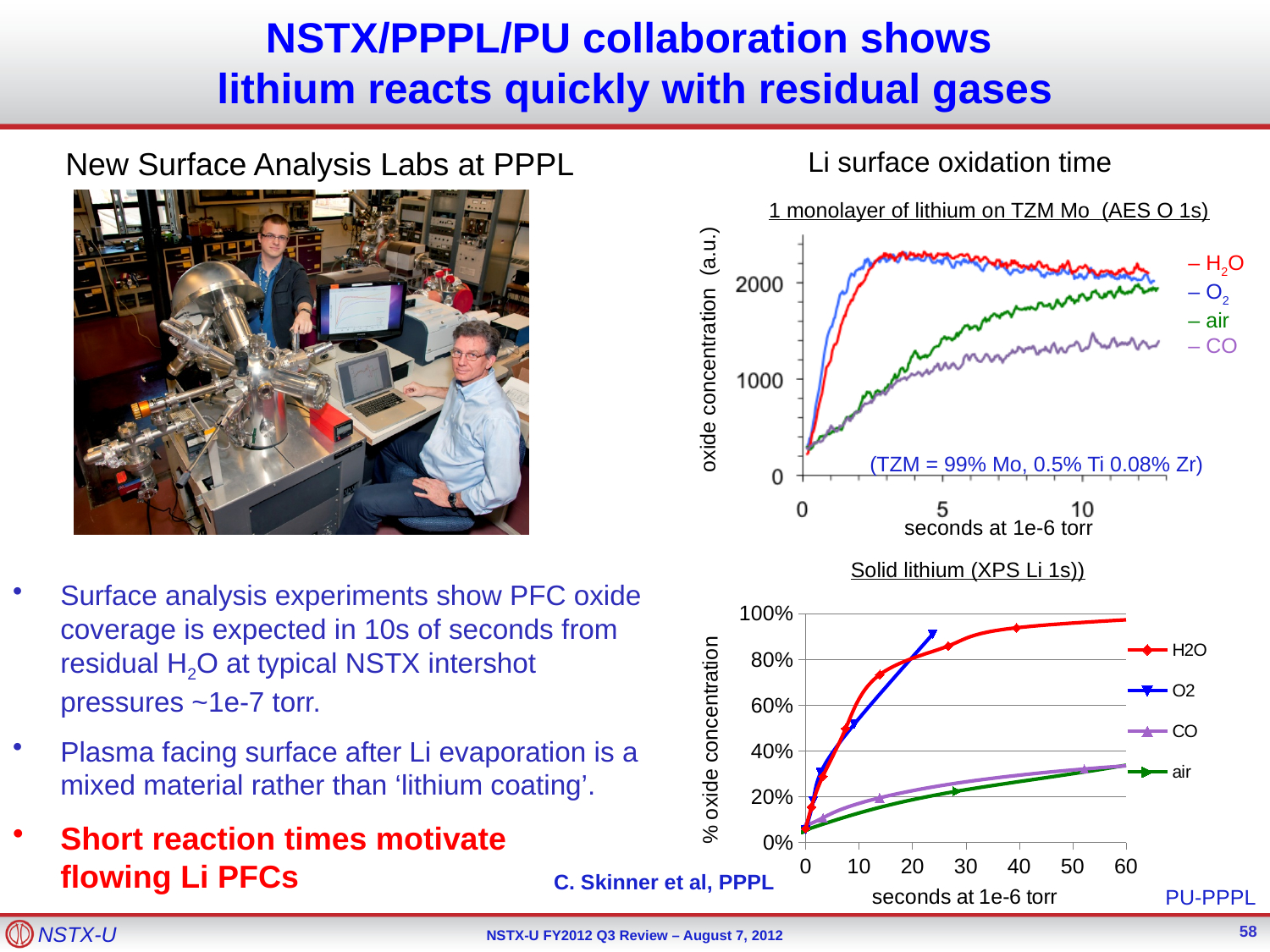
What is the x-axis label of the 'Solid lithium (XPS Li 1s)' chart? seconds at 1e-6 torr In the 'Solid lithium (XPS Li 1s)' chart, is the air value at 30 seconds greater or less than 40%? less In the 'Solid lithium (XPS Li 1s)' chart, is the H2O value at 40 seconds greater or less than 80%? greater In the 'Solid lithium (XPS Li 1s)' chart, which series has the highest value at 40 seconds? H2O In the '1 monolayer of lithium on TZM Mo (AES O 1s)' chart, which series has the lowest value at 10 seconds? CO What kind of chart is the 'Solid lithium (XPS Li 1s)' chart? line chart How many series does the legend of the '1 monolayer of lithium on TZM Mo (AES O 1s)' chart list? 4 How many series does the legend of the 'Solid lithium (XPS Li 1s)' chart list? 4 In the 'Solid lithium (XPS Li 1s)' chart, is the CO value at 50 seconds greater or less than 40%? less In the 'Solid lithium (XPS Li 1s)' chart, do the values for H2O rise or fall as seconds increase? rise